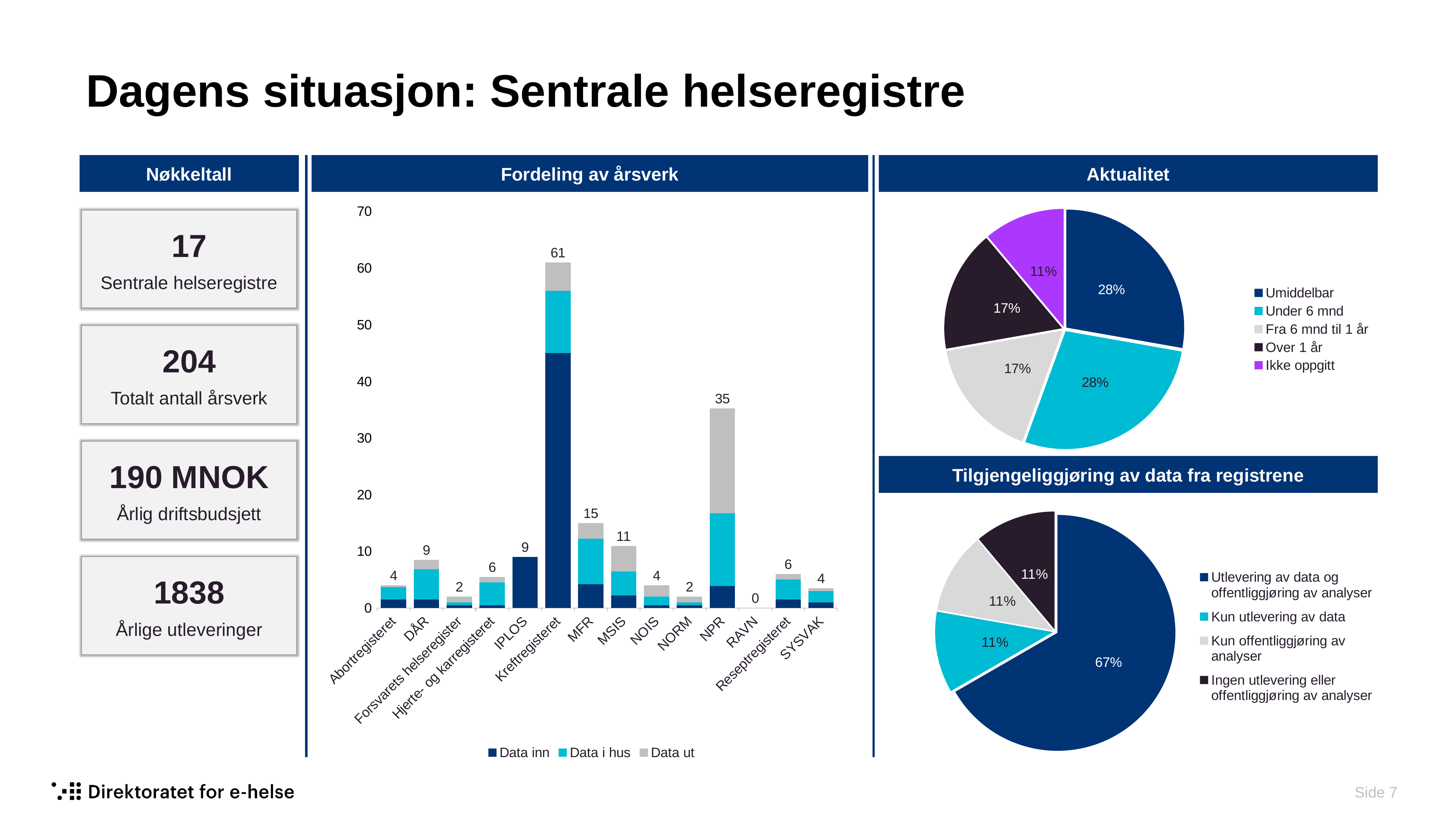
In the 'Fordeling av årsverk' chart, which has a larger total, MFR or MSIS? MFR In the 'Fordeling av årsverk' chart, what is the difference between the totals for Kreftregisteret and NPR? 26 In the 'Fordeling av årsverk' chart, which category has the lowest total? RAVN In the 'Tilgjengeliggjøring av data fra registrene' pie chart, what share is labelled for 'Utlevering av data og offentliggjøring av analyser'? 67% In the 'Fordeling av årsverk' chart, how many categories are shown on the x axis? 14 In the 'Fordeling av årsverk' chart, which category has the highest total? Kreftregisteret In the 'Fordeling av årsverk' chart, what is the total value labelled for NPR? 35 In the 'Fordeling av årsverk' chart, how many series does the legend list? 3 In the 'Aktualitet' pie chart, what share is labelled for 'Ikke oppgitt'? 11% In the 'Fordeling av årsverk' chart, what is the total value labelled for Kreftregisteret? 61 In the 'Aktualitet' pie chart, how many slices are there? 5 What kind of chart is 'Fordeling av årsverk'? Stacked bar chart